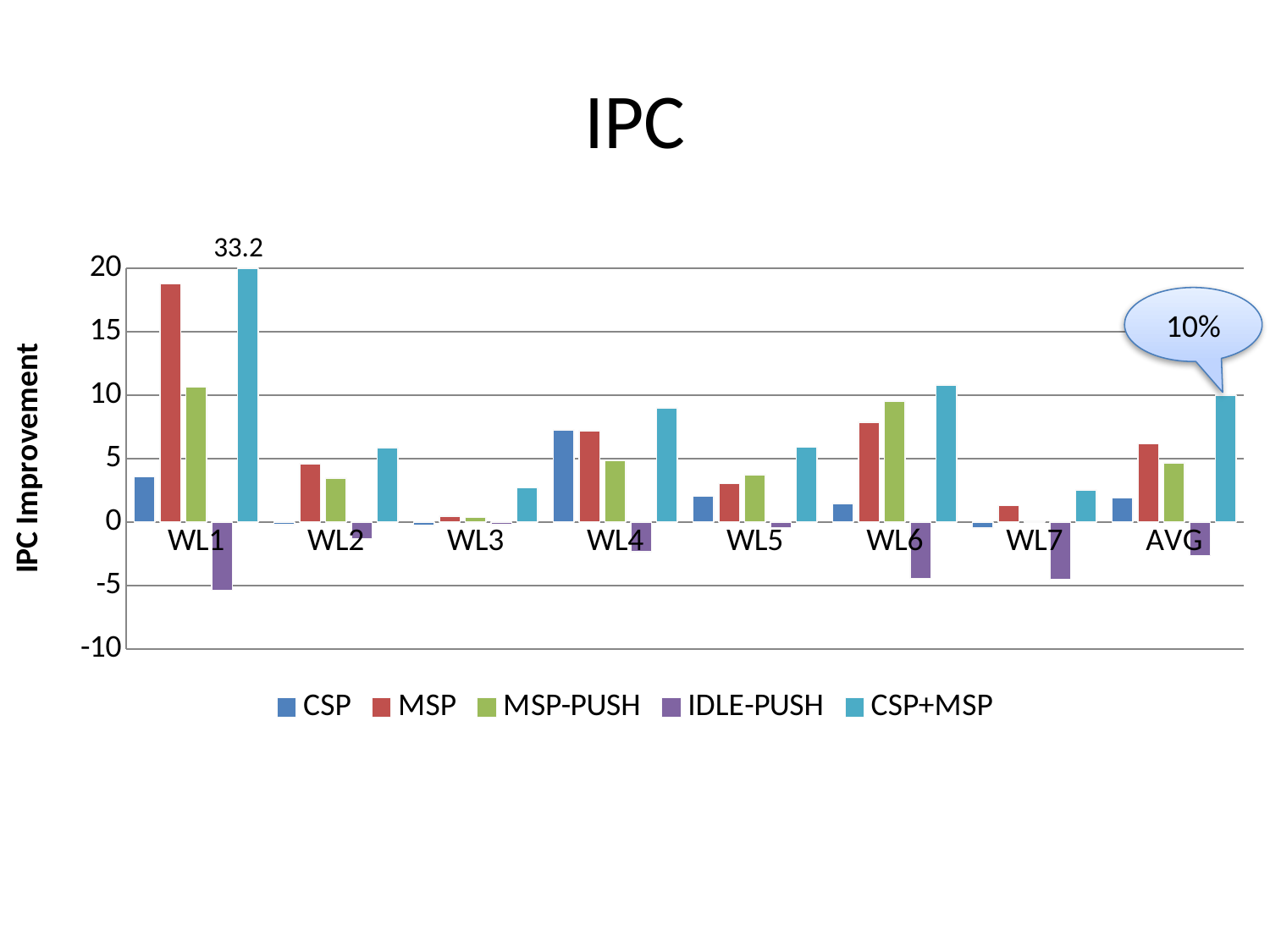
For WL1, which is larger: the MSP value or the MSP-PUSH value? MSP Which category has the highest CSP+MSP value? WL1 How many categories are shown along the x axis? 8 What is the CSP+MSP value for WL1? 33.2 Is the CSP+MSP value for WL4 greater or less than 10? less For WL6, which is larger: the MSP value or the MSP-PUSH value? MSP-PUSH Is the MSP value for WL1 greater or less than 15? greater Is the IDLE-PUSH value for WL1 greater or less than 0? less What is the label on the y axis? IPC Improvement How many series does the legend list? 5 What kind of chart is shown on the slide? bar chart Which category has the lowest MSP value? WL3